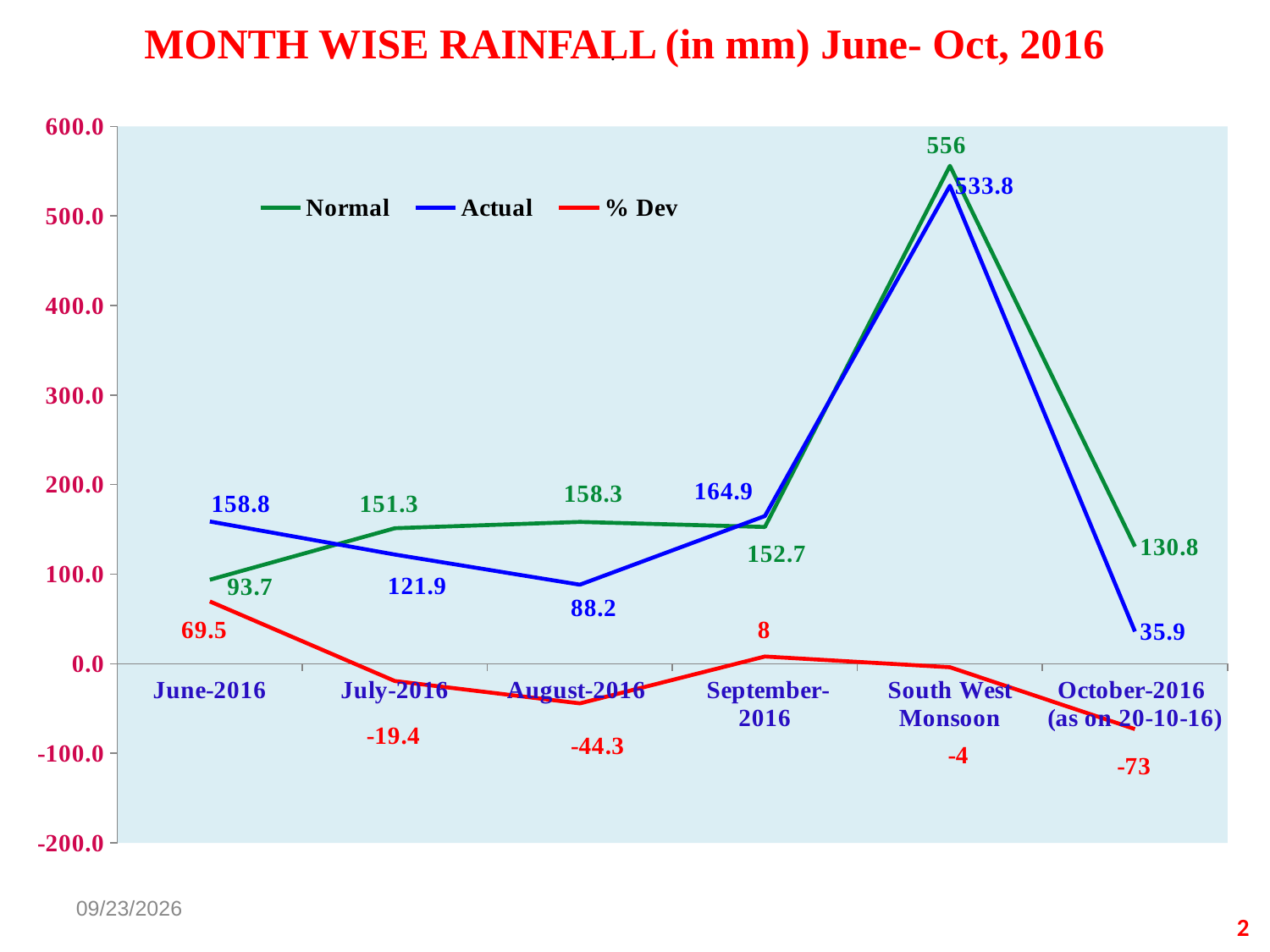
What is the difference between the Normal and Actual values for South West Monsoon? 22.2 How many categories are shown on the x axis? 6 What is the % Dev value for October-2016 (as on 20-10-16)? -73 How many series does the legend list? 3 For July-2016, which is larger, the Normal value or the Actual value? Normal Which category has the lowest Actual rainfall value? October-2016 (as on 20-10-16) What is the difference between the Actual values for June-2016 and August-2016? 70.6 What kind of chart is shown on the slide? line chart What is the Normal rainfall value for August-2016? 158.3 What is the Actual rainfall value for June-2016? 158.8 Is the Actual value for South West Monsoon greater or less than 500? greater Which category has the highest Normal rainfall value? South West Monsoon